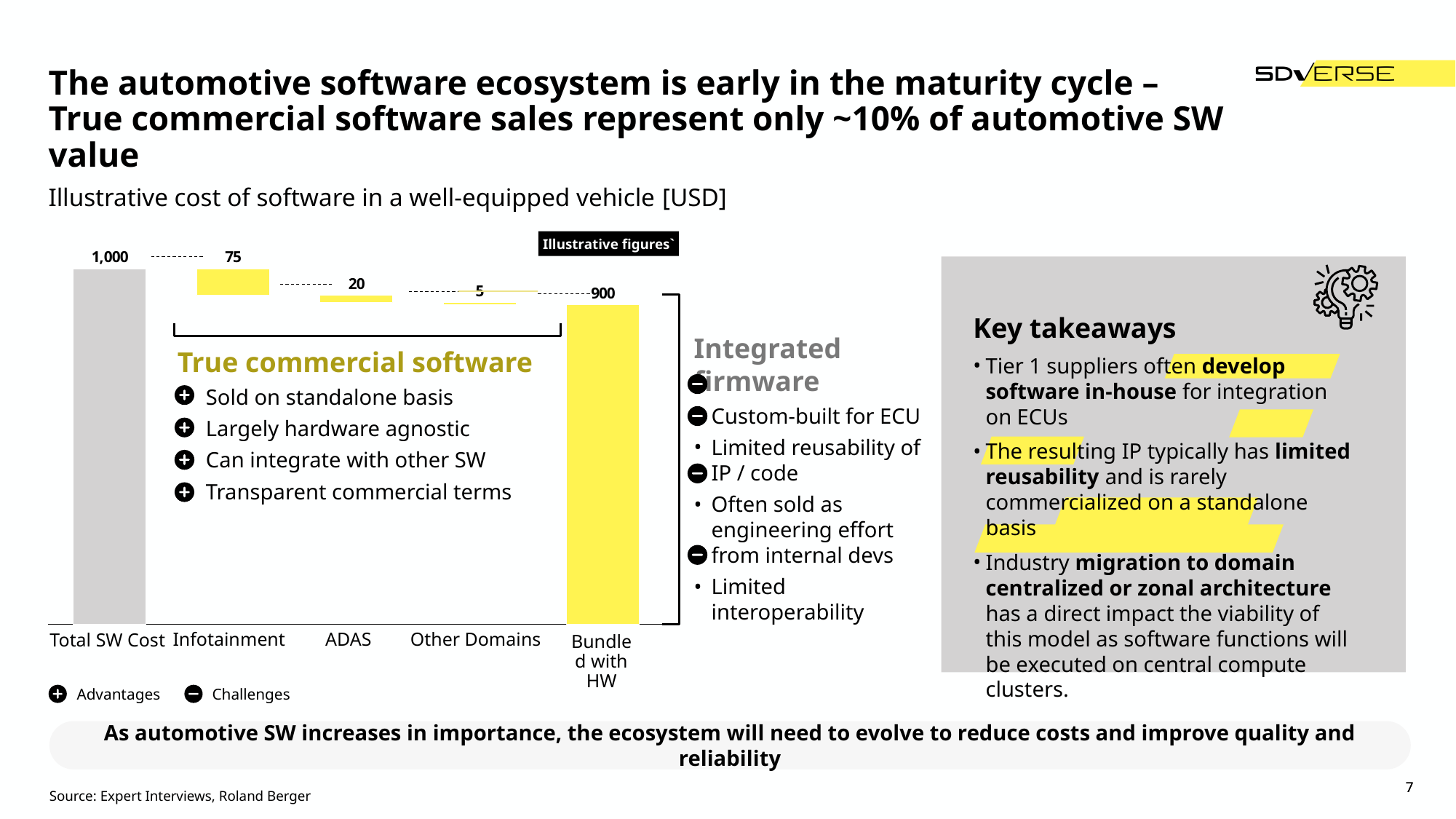
What is the value shown for Bundled with HW? 900 Which is larger, the value for Infotainment or the value for ADAS? Infotainment What is the combined value of the three categories grouped under 'True commercial software' (Infotainment, ADAS, Other Domains)? 100 What unit is given in the chart subtitle for the illustrative cost of software? USD What is the value shown for Other Domains? 5 What is the value shown for Total SW Cost? 1,000 How many categories are shown along the x axis of the chart? 5 What is the difference between the Infotainment value and the ADAS value? 55 Which category has the lowest value in the chart? Other Domains What is the value shown for Infotainment? 75 What is the value shown for ADAS? 20 Which category has the highest value in the chart? Total SW Cost